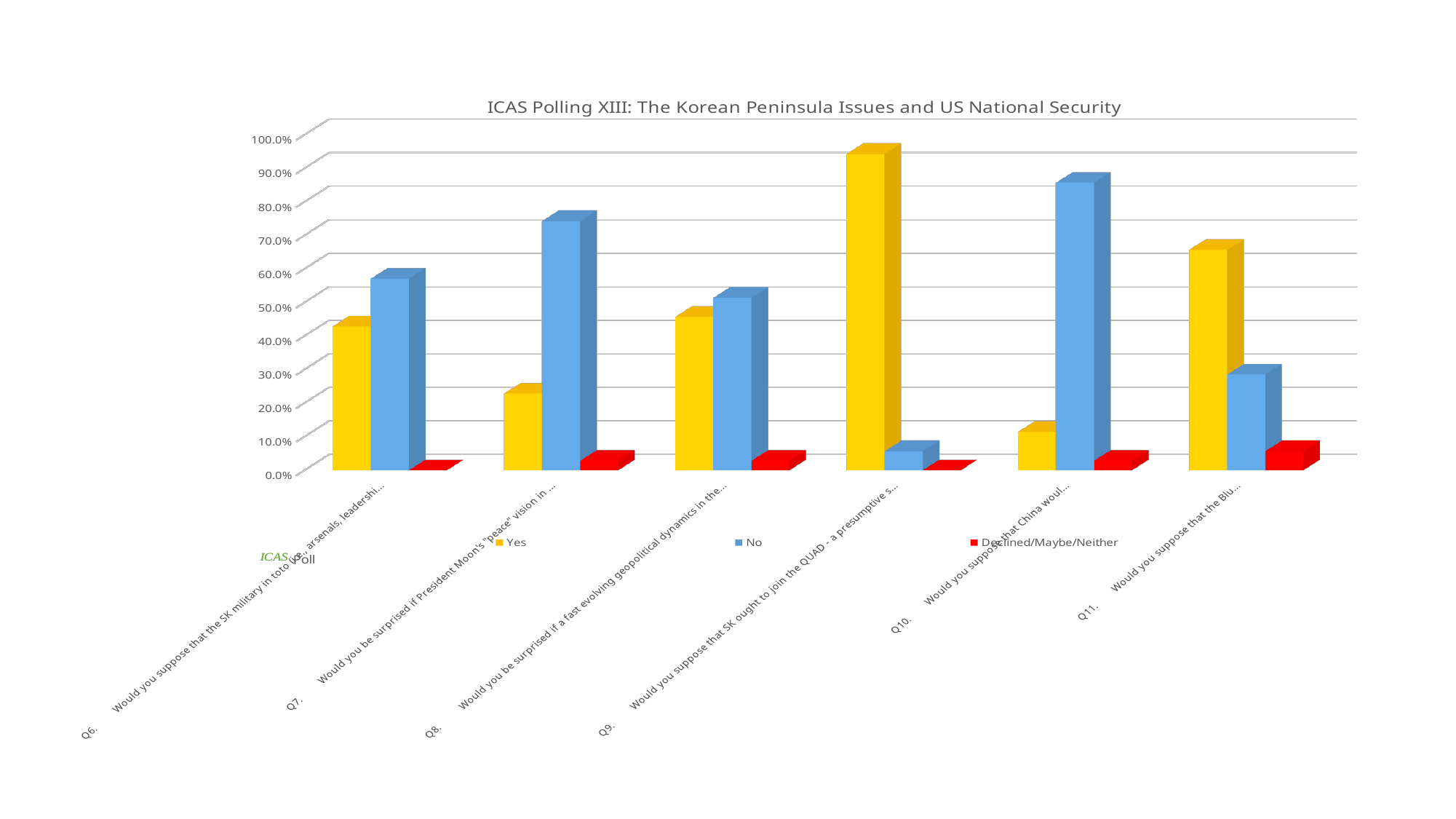
What is the title of the chart? ICAS Polling XIII: The Korean Peninsula Issues and US National Security Is the "Yes" value for Q7 greater or less than 30.0%? less Which question has the lowest "Yes" value? Q10 How many question categories are plotted along the x axis? 6 How many series does the legend list? 3 For Q11, which is larger, the "Yes" value or the "No" value? Yes Is the "Yes" value for Q9 greater or less than 90.0%? greater For Q7, which is larger, the "Yes" value or the "No" value? No Which question has the highest "Yes" value? Q9 What kind of chart is shown on the slide? Bar chart Which question has the lowest "No" value? Q9 Which question has the highest "No" value? Q10